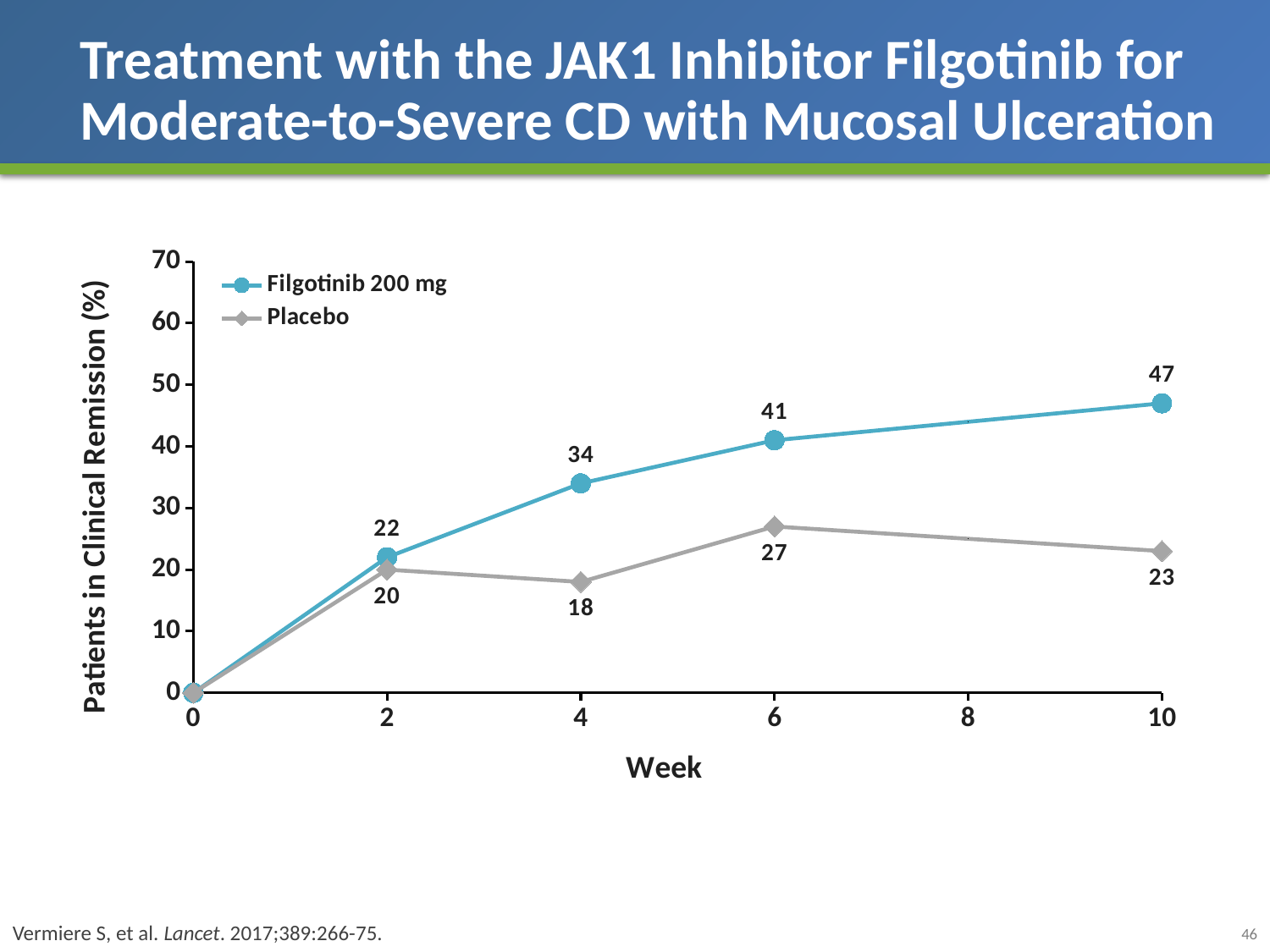
What kind of chart is shown on the slide? Line chart How many series does the legend list? 2 What is the difference between Filgotinib 200 mg and Placebo at week 4? 16 Does the Filgotinib 200 mg series rise or fall from week 2 to week 10? Rise What is the difference between Filgotinib 200 mg and Placebo at week 10? 24 What is the value for Placebo at week 4? 18 At which week does Filgotinib 200 mg reach its highest value? 10 At which week does Placebo reach its highest value? 6 Which series has the larger value at week 6, Filgotinib 200 mg or Placebo? Filgotinib 200 mg What is the value for Placebo at week 2? 20 What is the value for Filgotinib 200 mg at week 6? 41 What is the value for Filgotinib 200 mg at week 10? 47